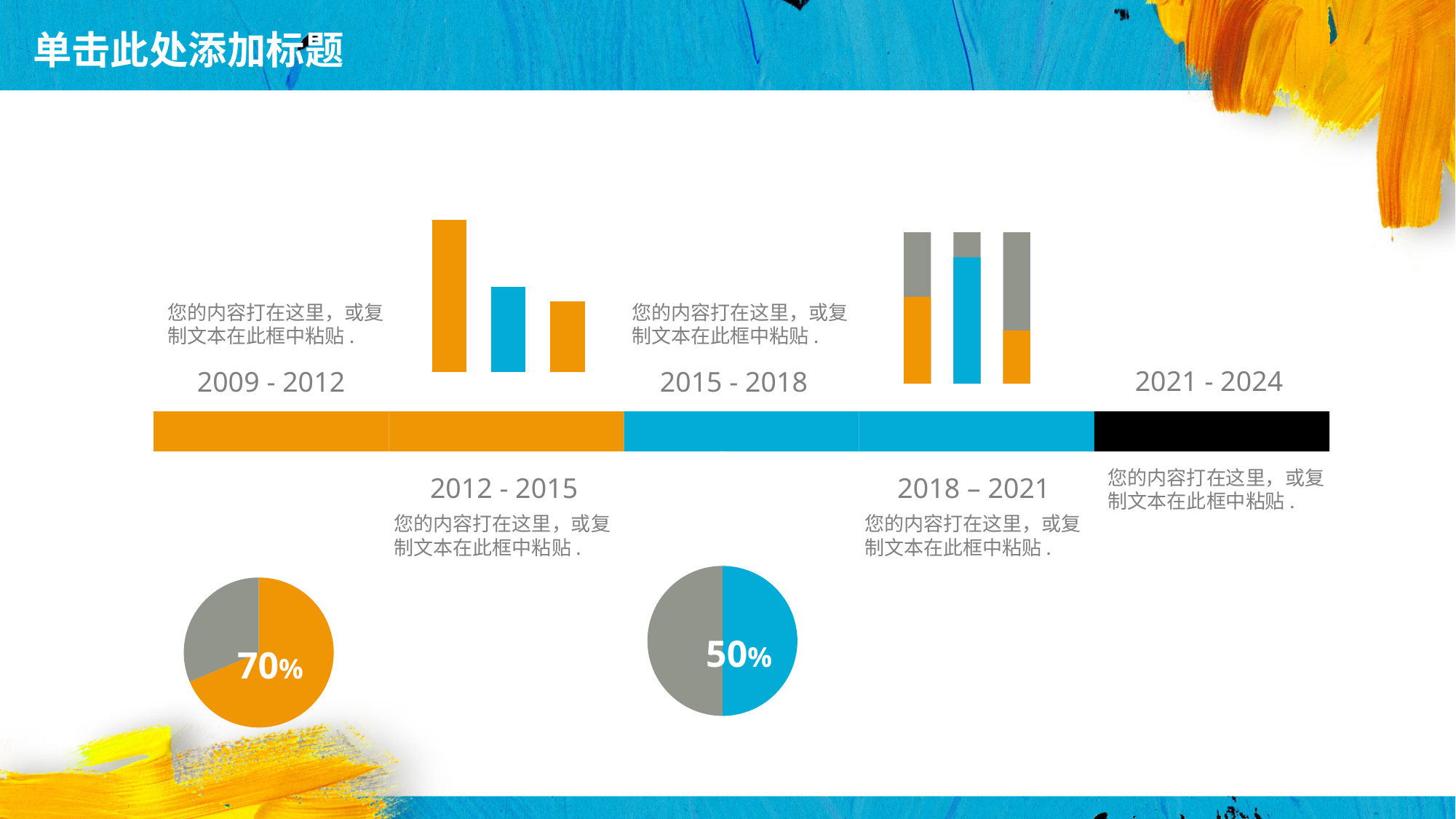
What percentage is labelled on the bottom-left pie chart? 70% In the bar chart above the 2012 - 2015 label, which bar is the shortest: the first, second or third? the third What kind of chart is shown above the 2012 - 2015 label on the timeline? bar chart What percentage is labelled on the bottom-centre pie chart? 50% In the bar chart above the 2012 - 2015 label, what colour is the middle bar? blue In the bar chart above the 2012 - 2015 label, which bar is the tallest: the first, second or third? the first How many bars are in the stacked bar chart above the 2018 – 2021 label? 3 What kind of chart is shown at the bottom left of the slide? pie chart What is the difference between the labelled share of the bottom-left pie chart and that of the bottom-centre pie chart? 20% In the stacked bar chart above the 2018 – 2021 label, which bar has the largest coloured (non-grey) segment: the first, second or third? the second Which pie chart shows the larger labelled share, the bottom-left one or the bottom-centre one? the bottom-left one How many bars are in the bar chart above the 2012 - 2015 label? 3